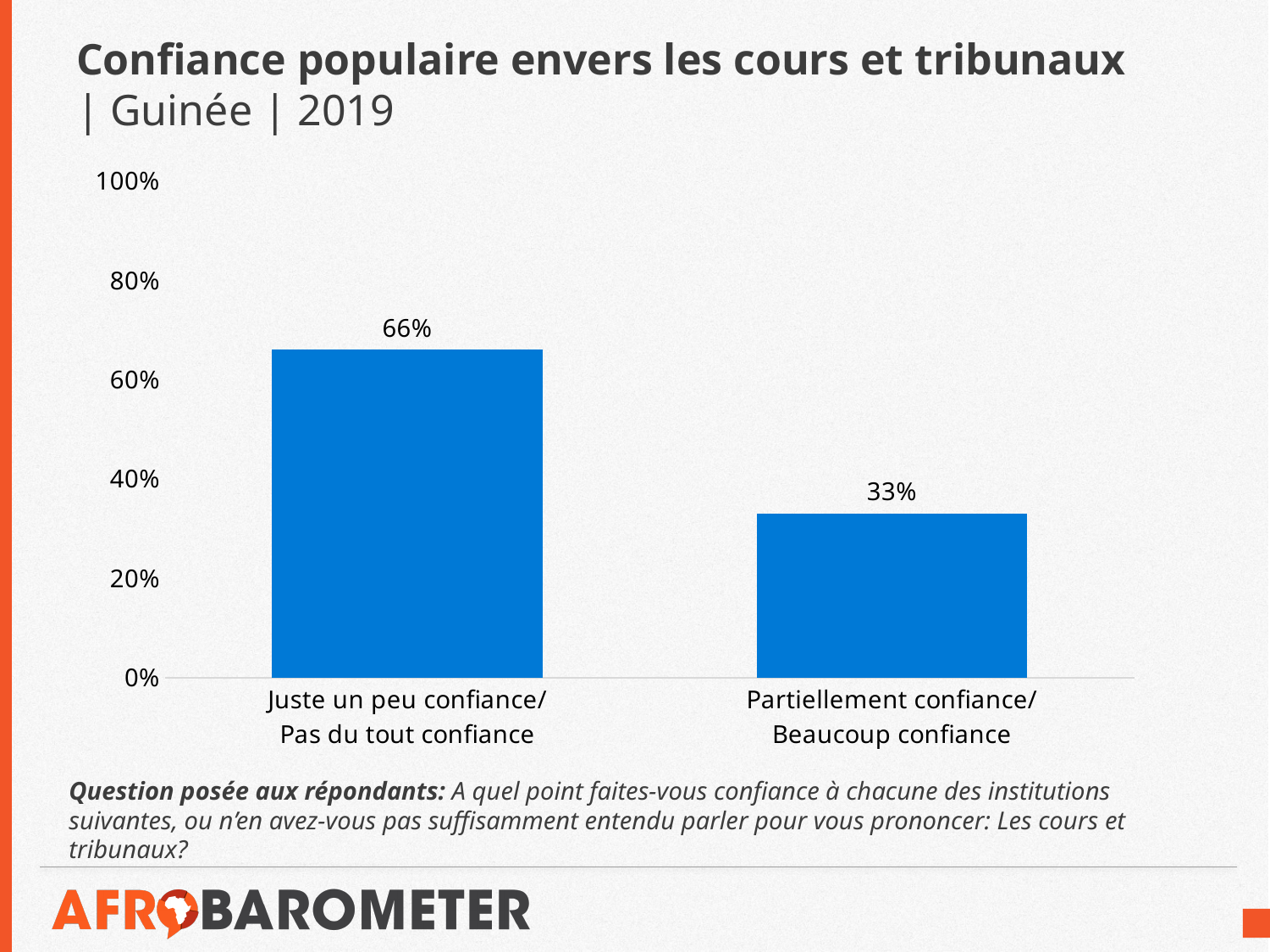
Which category has the lowest value? Partiellement confiance/ Beaucoup confiance Is the value for "Juste un peu confiance/ Pas du tout confiance" greater or less than 60%? greater What is the difference between the values for "Juste un peu confiance/ Pas du tout confiance" and "Partiellement confiance/ Beaucoup confiance"? 33% What kind of chart is shown on the slide? bar chart What is the value for "Juste un peu confiance/ Pas du tout confiance"? 66% Which category has the highest value? Juste un peu confiance/ Pas du tout confiance Which is larger: the value for "Juste un peu confiance/ Pas du tout confiance" or the value for "Partiellement confiance/ Beaucoup confiance"? Juste un peu confiance/ Pas du tout confiance What is the title of the chart? Confiance populaire envers les cours et tribunaux | Guinée | 2019 How many categories are shown in the chart? 2 What is the value for "Partiellement confiance/ Beaucoup confiance"? 33% Is the value for "Partiellement confiance/ Beaucoup confiance" greater or less than 40%? less What is the highest value shown on the vertical axis? 100%